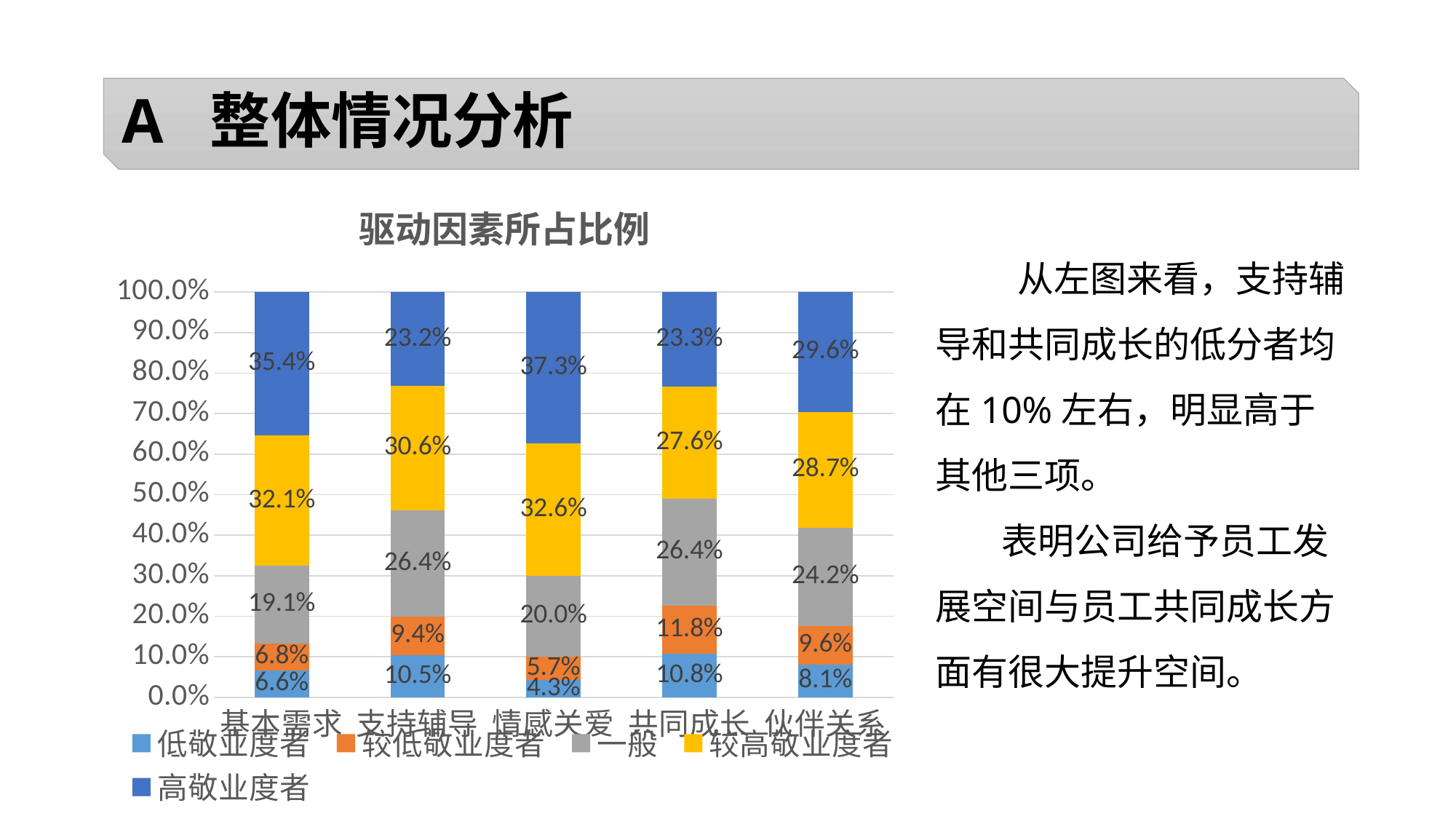
Which category has the highest value for 较低敬业度者? 共同成长 What is the value of 低敬业度者 for 支持辅导? 10.5% Which is larger: the 较高敬业度者 value for 基本需求 or for 共同成长? 基本需求 What is the value of 高敬业度者 for 情感关爱? 37.3% Which category has the lowest value for 低敬业度者? 情感关爱 What is the difference between the 高敬业度者 values for 基本需求 and 支持辅导? 12.2% What is the title of the chart? 驱动因素所占比例 How many series does the chart's legend list? 5 How many categories are shown on the x axis of the chart? 5 What kind of chart is shown on the slide? stacked bar chart Which series is shown in yellow in the chart? 较高敬业度者 What is the value of 一般 for 伙伴关系? 24.2%